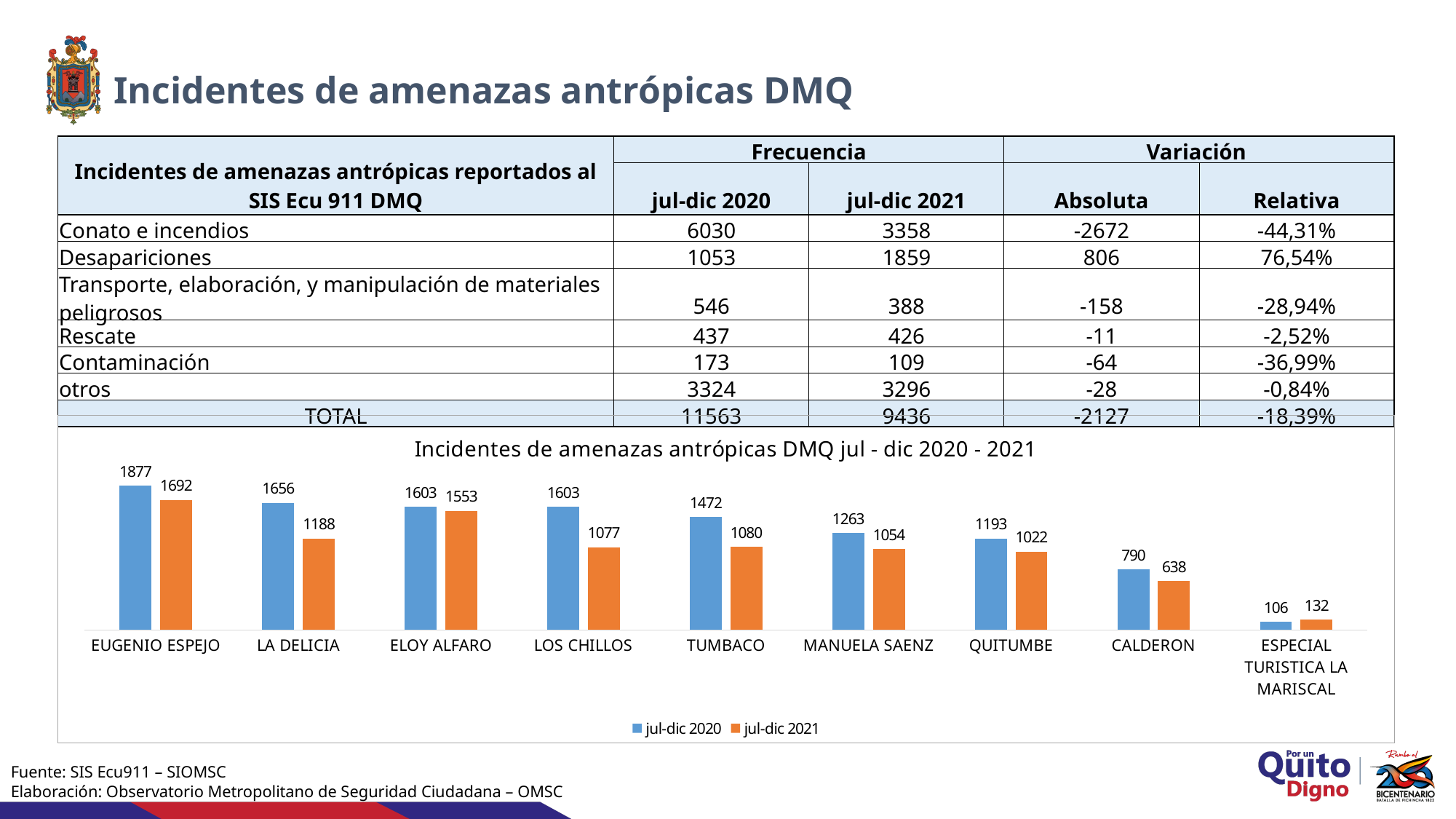
What is the difference between the jul-dic 2020 values for EUGENIO ESPEJO and CALDERON? 1087 What is the jul-dic 2021 value for ESPECIAL TURISTICA LA MARISCAL? 132 Which category has the highest jul-dic 2020 value? EUGENIO ESPEJO Which is larger for ESPECIAL TURISTICA LA MARISCAL, the jul-dic 2020 value or the jul-dic 2021 value? jul-dic 2021 What type of chart is shown on the slide? Bar chart What is the jul-dic 2020 value for LA DELICIA? 1656 How many series does the chart legend list? 2 Which category has the lowest jul-dic 2021 value? ESPECIAL TURISTICA LA MARISCAL How many categories are shown on the x axis of the chart? 9 Which is larger, the jul-dic 2021 value for ELOY ALFARO or the jul-dic 2021 value for LA DELICIA? ELOY ALFARO What is the difference between the jul-dic 2020 and jul-dic 2021 values for LOS CHILLOS? 526 What is the jul-dic 2021 value for TUMBACO? 1080